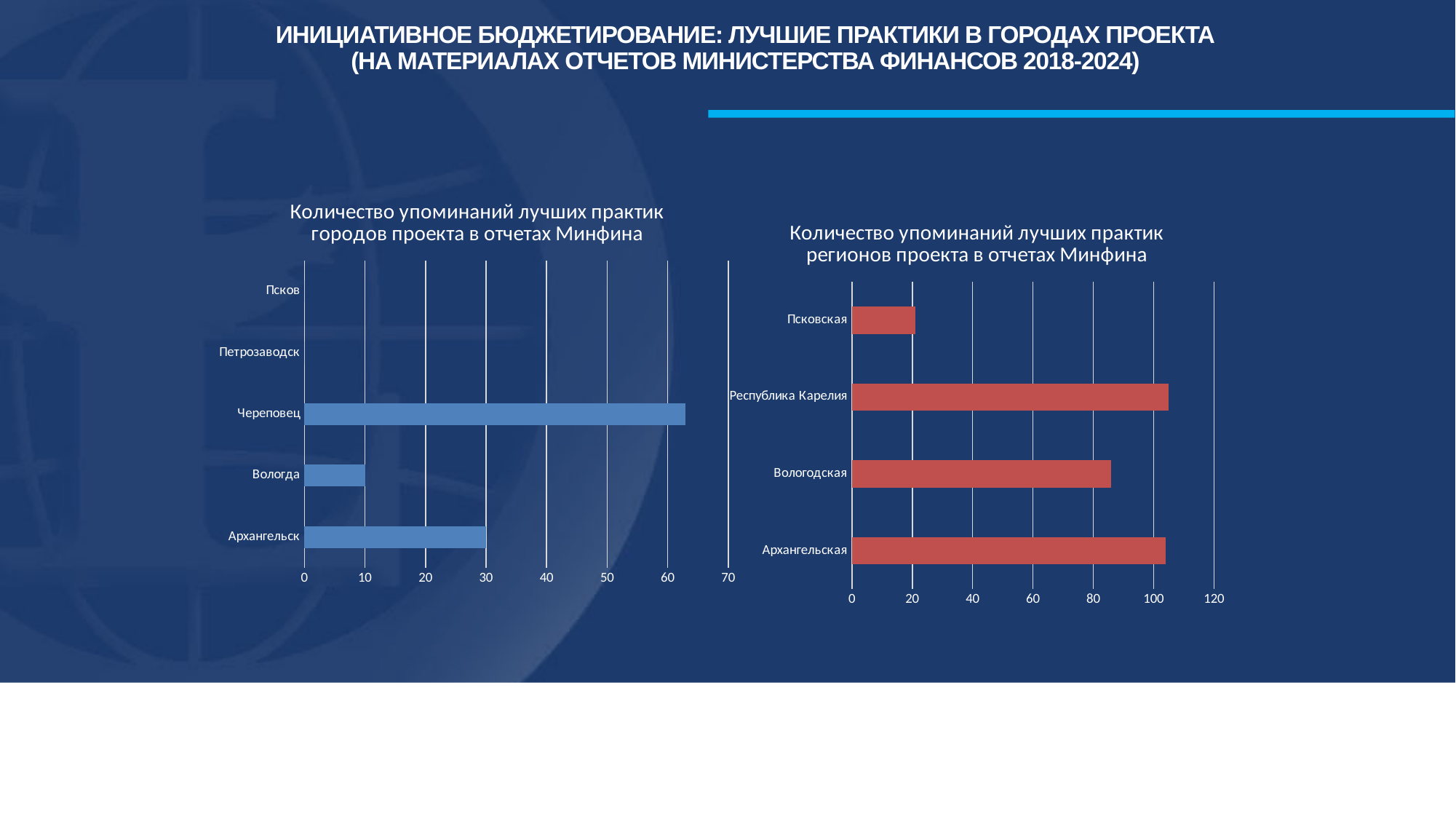
In the right chart (regions), is the value for Псковская greater or less than 40? less In the right chart (regions), which region has the lowest number of mentions? Псковская How many regions are listed on the right chart (regions)? 4 In the left chart (cities), what is the value for Вологда? 10 In the left chart (cities), which is larger, the value for Череповец or the value for Архангельск? Череповец In the right chart (regions), is the value for Вологодская greater or less than 80? greater In the left chart (cities), what is the value for Архангельск? 30 In the right chart (regions), which is larger, the value for Вологодская or the value for Псковская? Вологодская How many cities are listed on the left chart (cities)? 5 What kind of chart is the left chart, 'Количество упоминаний лучших практик городов проекта в отчетах Минфина'? bar chart In the left chart (cities), is the value for Череповец greater or less than 60? greater In the left chart (cities), which city has the highest number of mentions? Череповец